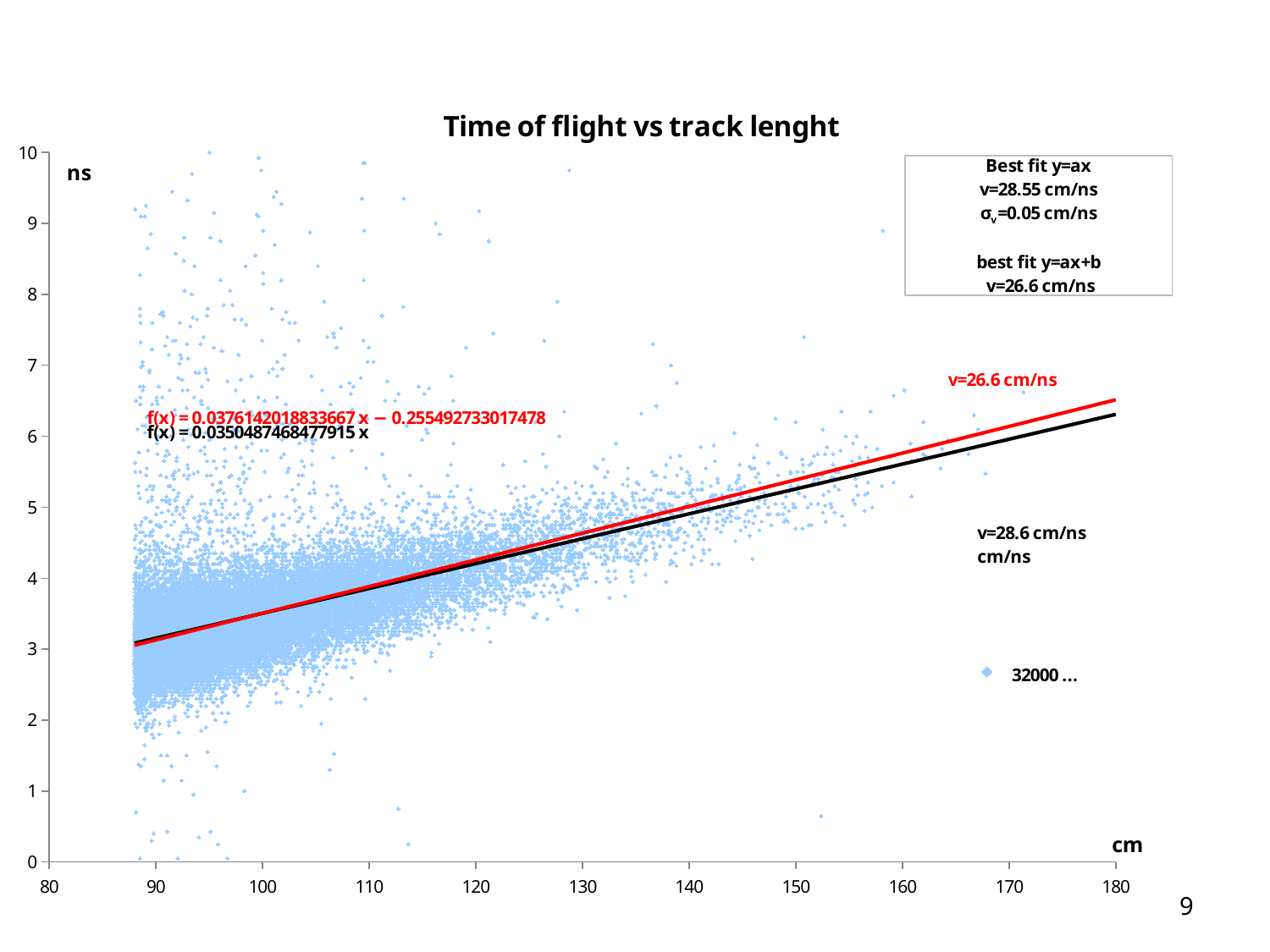
Is the value of the red trendline at 180 cm greater or less than 6 ns? greater What is the slope of the red trendline equation f(x) printed on the chart? 0.0376142018833667 Do the plotted time-of-flight values rise or fall as track length increases along the x axis? rise According to the text box, what is σv for the best fit y=ax? 0.05 cm/ns What kind of chart is shown on the slide? scatter chart According to the text box, what is the velocity v for the best fit y=ax? 28.55 cm/ns According to the text box, what is the velocity v for the best fit y=ax+b? 26.6 cm/ns Is the value of the black trendline at 90 cm greater or less than 4 ns? less What is the title of the chart? Time of flight vs track lenght What is the slope of the black trendline equation f(x) printed on the chart? 0.0350487468477915 What is the intercept term in the red trendline equation printed on the chart? −0.255492733017478 How many series does the legend list? 1